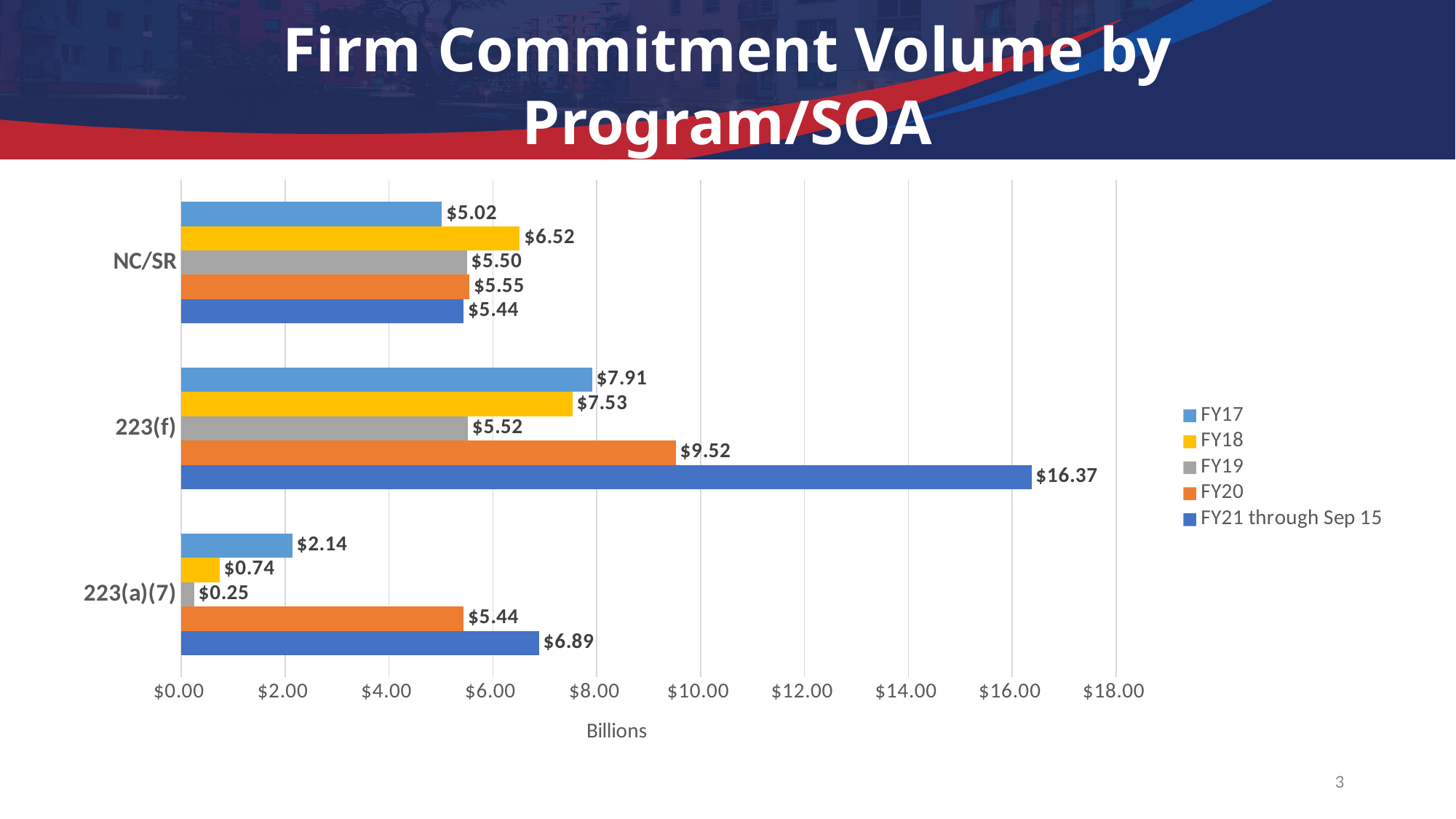
What is the FY21 through Sep 15 value for 223(f)? $16.37 What is the difference between the FY21 through Sep 15 and FY20 values for 223(f)? $6.85 Which is larger for NC/SR, the FY17 value or the FY18 value? FY18 What kind of chart is shown on the slide? bar chart What is the FY19 value for 223(a)(7)? $0.25 What is the FY18 value for NC/SR? $6.52 How many series does the legend list? 5 What unit is shown on the x axis label? Billions Which program has the lowest FY17 value? 223(a)(7) How many programs are shown on the chart? 3 Which program has the highest FY20 value? 223(f) Is the FY20 value for 223(f) greater or less than $8.00? greater